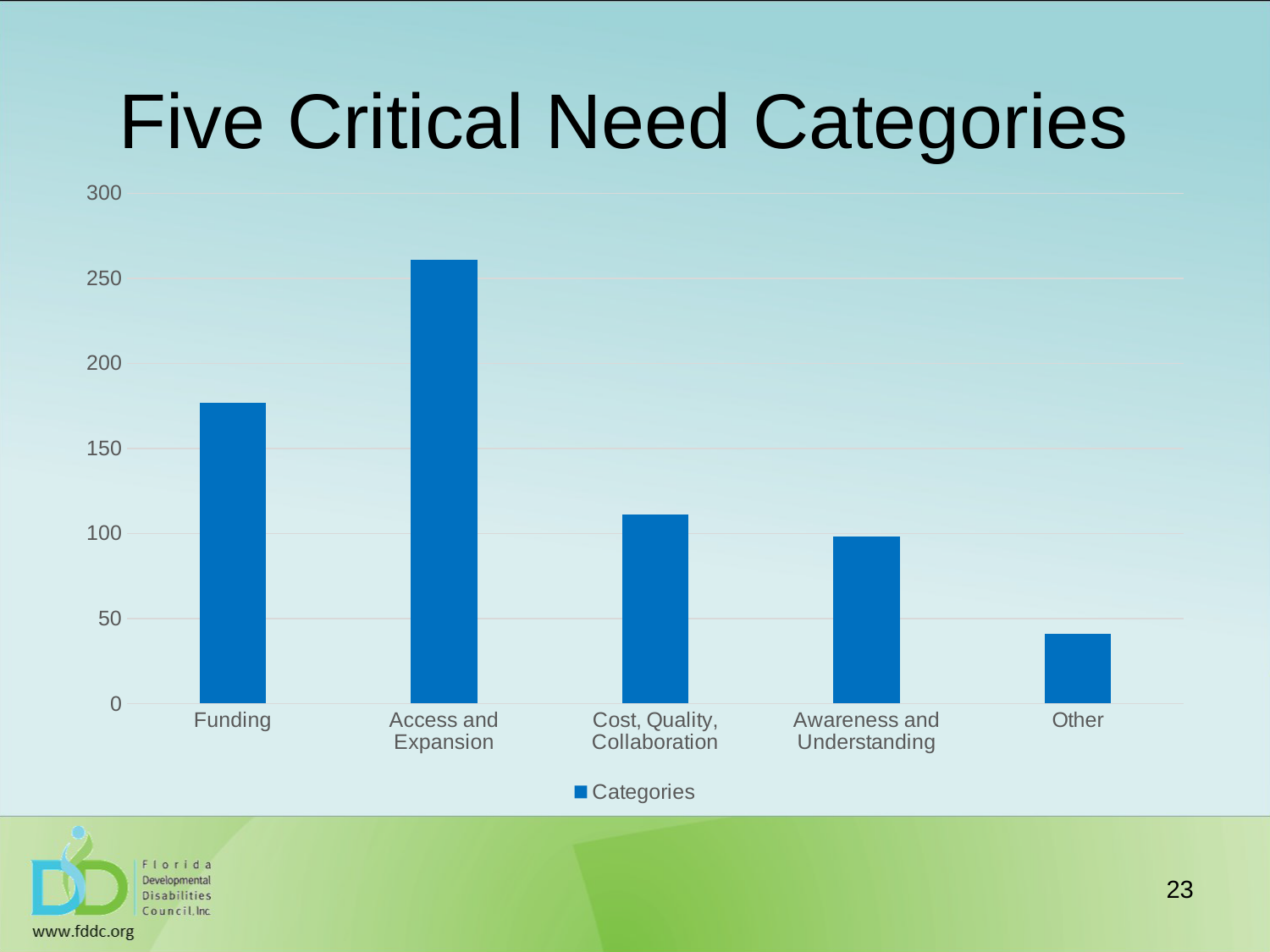
What is the title of the slide containing the chart? Five Critical Need Categories How many series does the legend list? 1 Is the value for Funding greater or less than 150? greater Which category has the highest bar? Access and Expansion What kind of chart is shown on the slide? bar chart Is the value for Other greater or less than 50? less Is the value for Cost, Quality, Collaboration greater or less than 100? greater Which is larger, the value for Funding or the value for Cost, Quality, Collaboration? Funding Which category has the lowest bar? Other How many categories are shown on the x axis? 5